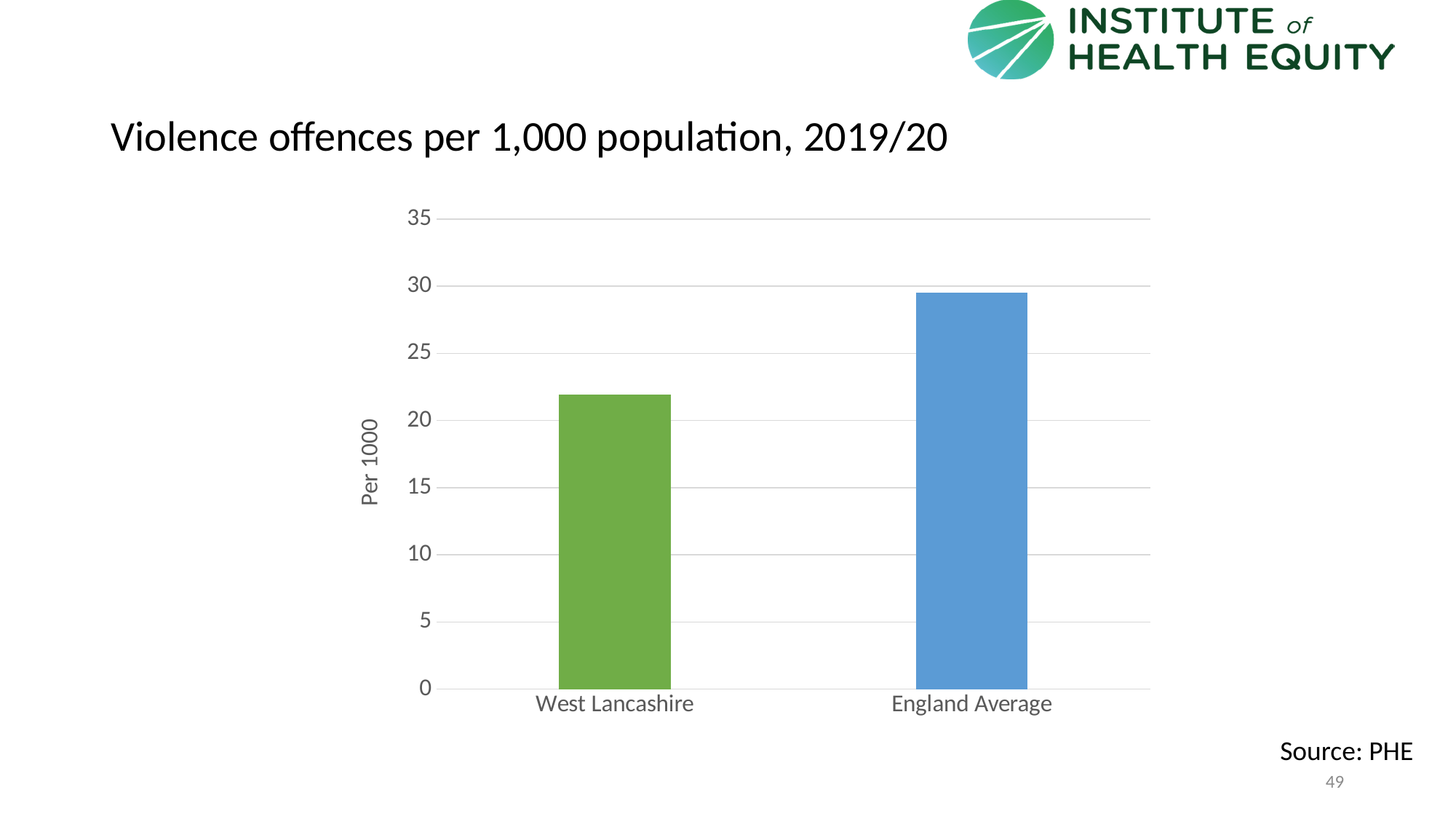
Is the value for West Lancashire greater or less than 25? less What is the label on the vertical axis? Per 1000 Is the value for West Lancashire greater or less than 20? greater Which category has the highest value? England Average Which is larger, the value for West Lancashire or the value for England Average? England Average Is the value for England Average greater or less than 25? greater How many categories are plotted in the chart? 2 What is the title of the chart? Violence offences per 1,000 population, 2019/20 Which category has the lowest value? West Lancashire What kind of chart is shown on the slide? bar chart